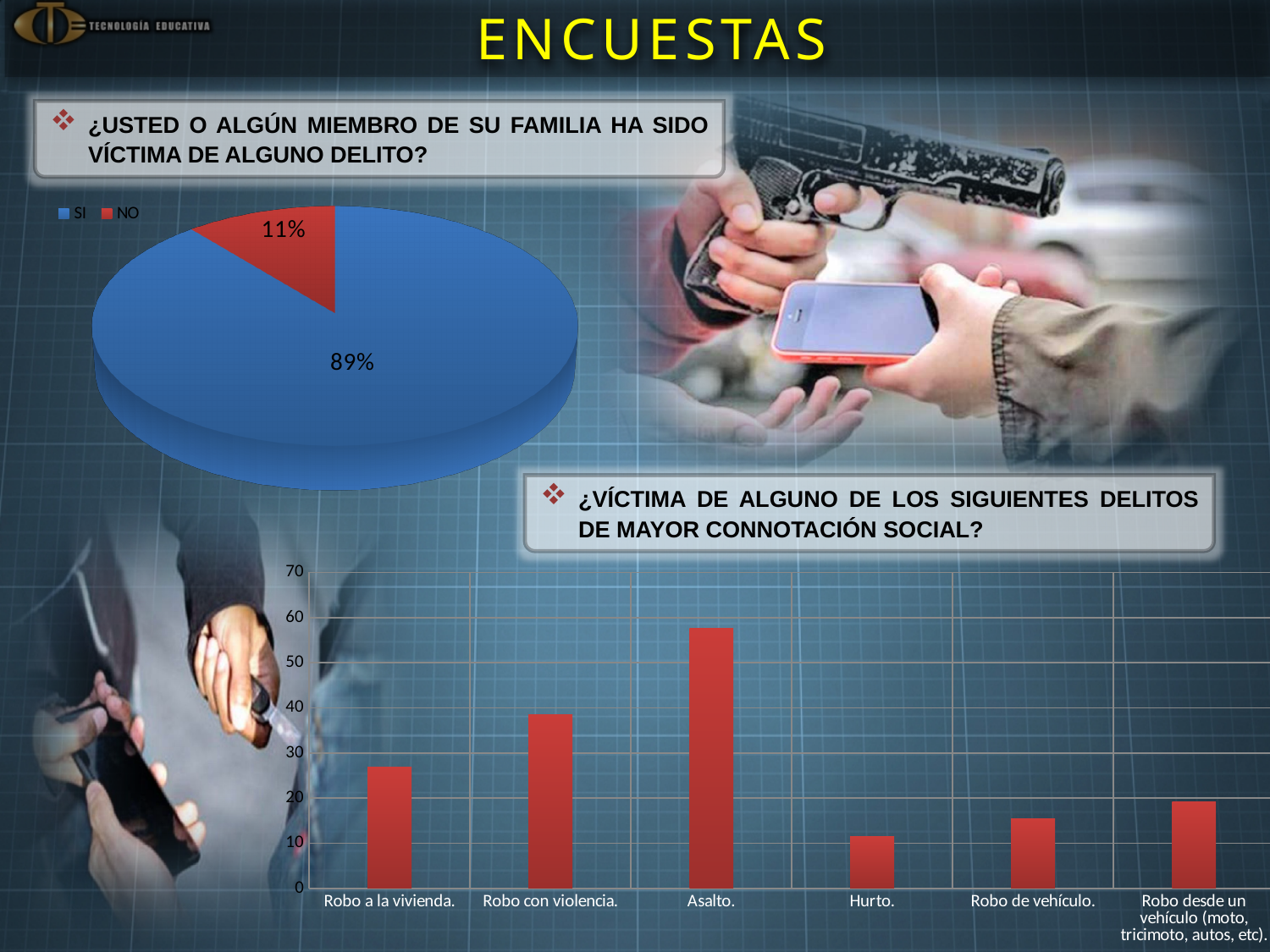
In the pie chart, what percentage of respondents answered SI? 89% In the pie chart, how many entries does the legend list? 2 In the bar chart at the bottom, which category has the highest value? Asalto. In the pie chart, which response has the larger share? SI In the bar chart at the bottom, which is larger: Robo con violencia or Robo a la vivienda? Robo con violencia. In the bar chart at the bottom, how many categories are shown on the x axis? 6 In the bar chart at the bottom, which category has the lowest value? Hurto. In the pie chart, what percentage of respondents answered NO? 11% What kind of chart is the chart at the top left of the slide? Pie chart What kind of chart is the chart at the bottom of the slide? Bar chart In the pie chart, by how many percentage points does SI exceed NO? 78 percentage points In the bar chart at the bottom, is the value for Asalto greater or less than 50? greater